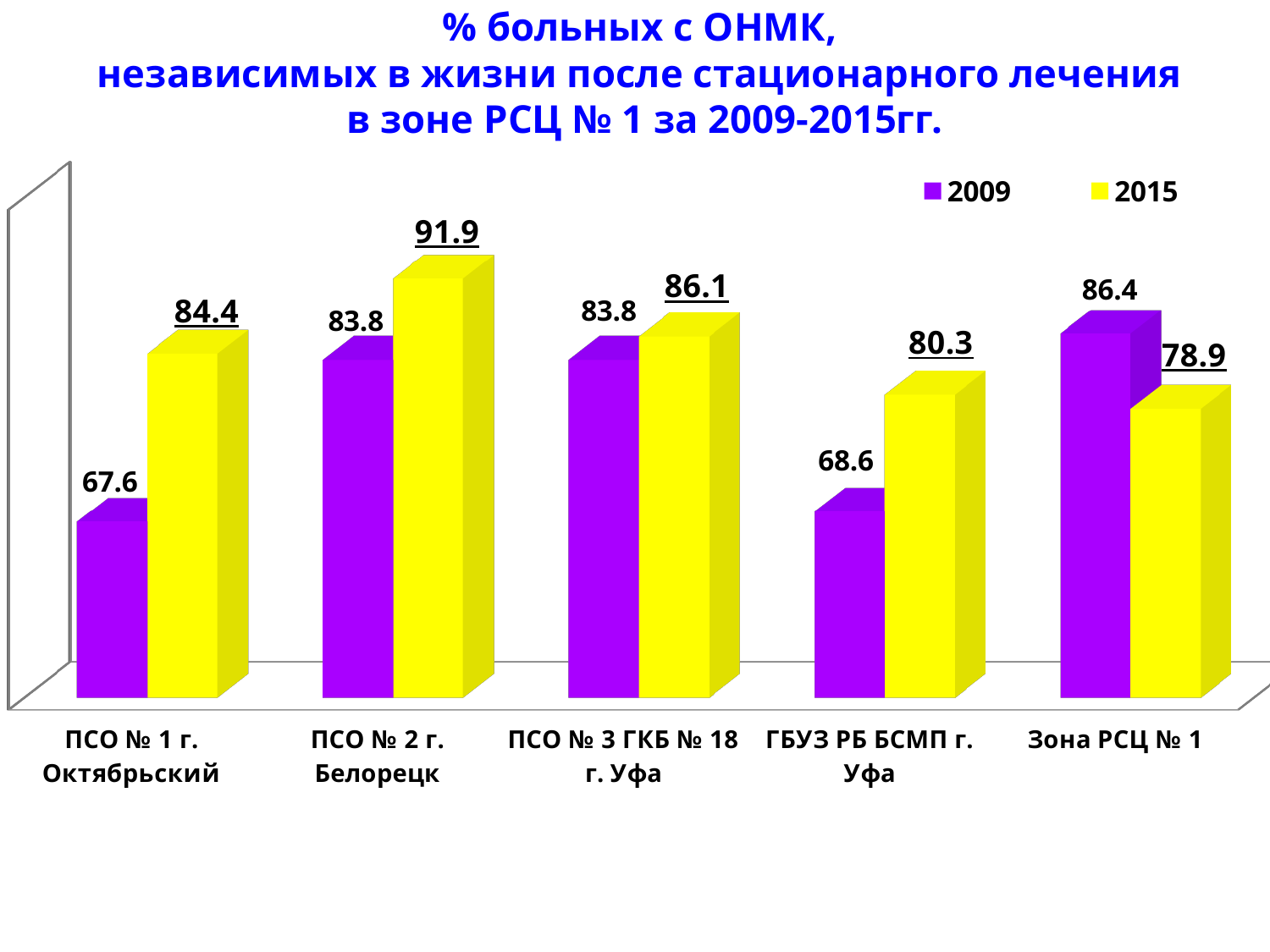
What is the difference between the 2015 and 2009 values for ПСО № 1 г. Октябрьский? 16.8 What kind of chart is shown on the slide? Bar chart Which category has the lowest 2009 value? ПСО № 1 г. Октябрьский How many series does the legend list? 2 What is the 2015 value for ПСО № 2 г. Белорецк? 91.9 What is the 2009 value for ПСО № 1 г. Октябрьский? 67.6 How many categories are shown on the x axis? 5 Which category has the highest 2015 value? ПСО № 2 г. Белорецк What is the 2015 value for ГБУЗ РБ БСМП г. Уфа? 80.3 What is the 2009 value for Зона РСЦ № 1? 86.4 What is the difference between the 2015 and 2009 values for ГБУЗ РБ БСМП г. Уфа? 11.7 For Зона РСЦ № 1, which is larger: the 2009 value or the 2015 value? 2009